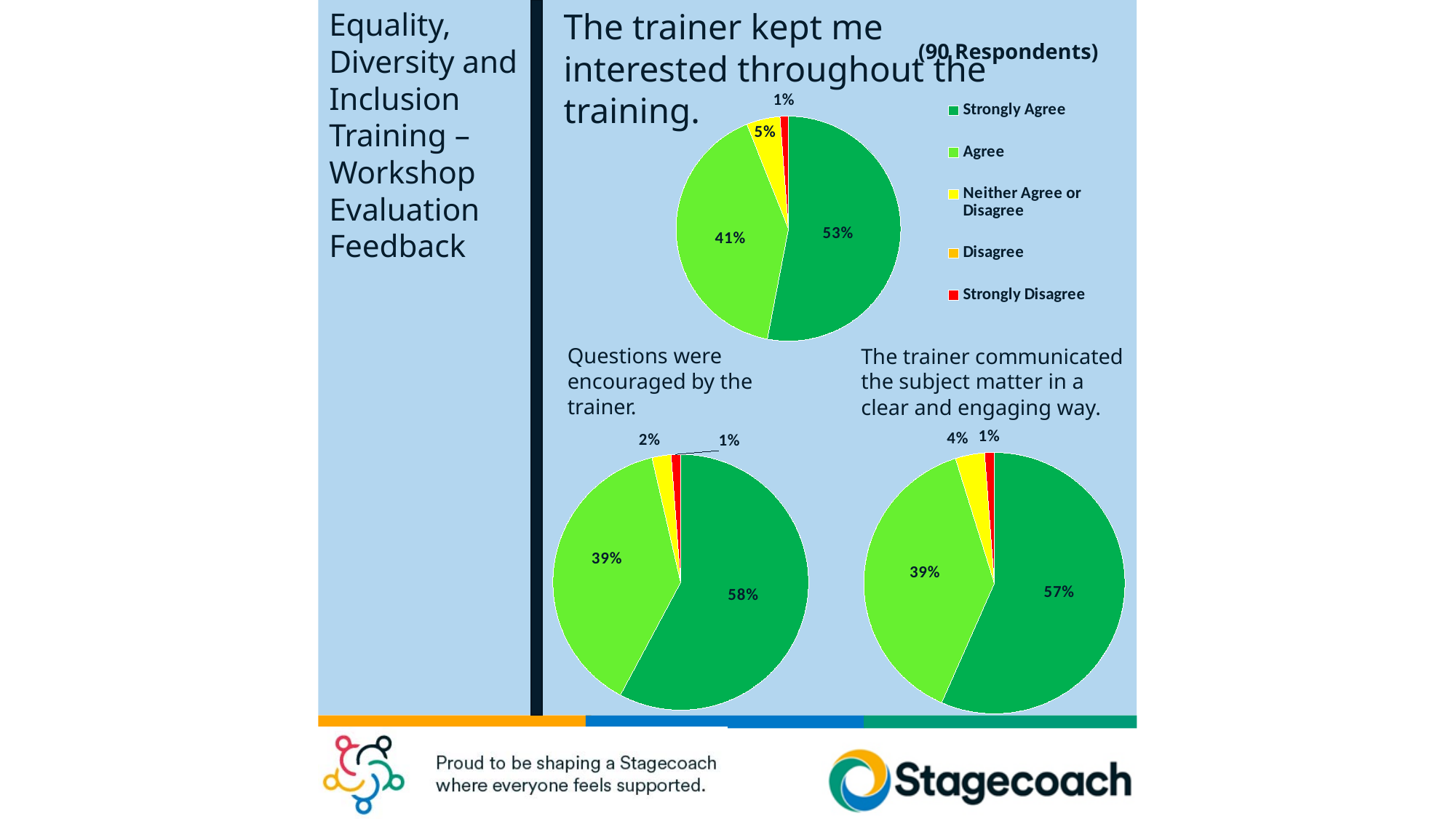
In the pie chart titled "The trainer kept me interested throughout the training.", what percentage chose Neither Agree or Disagree? 5% In the pie chart titled "The trainer communicated the subject matter in a clear and engaging way.", what percentage chose Agree? 39% What type of chart is used to show the responses on this slide? Pie chart In the pie chart titled "Questions were encouraged by the trainer.", what percentage chose Neither Agree or Disagree? 2% In the pie chart titled "The trainer kept me interested throughout the training.", what is the difference in percentage points between Strongly Agree and Agree? 12 Which is larger: the Strongly Agree share in "Questions were encouraged by the trainer." or the Strongly Agree share in "The trainer communicated the subject matter in a clear and engaging way."? Questions were encouraged by the trainer. In the pie chart titled "The trainer communicated the subject matter in a clear and engaging way.", which response has the largest share? Strongly Agree In the pie chart titled "The trainer kept me interested throughout the training.", what percentage chose Agree? 41% In the pie chart titled "Questions were encouraged by the trainer.", which response has the smallest share? Strongly Disagree How many entries does the legend list for the pie charts? 5 In the pie chart titled "Questions were encouraged by the trainer.", what percentage chose Strongly Agree? 58% In the pie chart titled "The trainer kept me interested throughout the training.", what percentage of respondents chose Strongly Agree? 53%